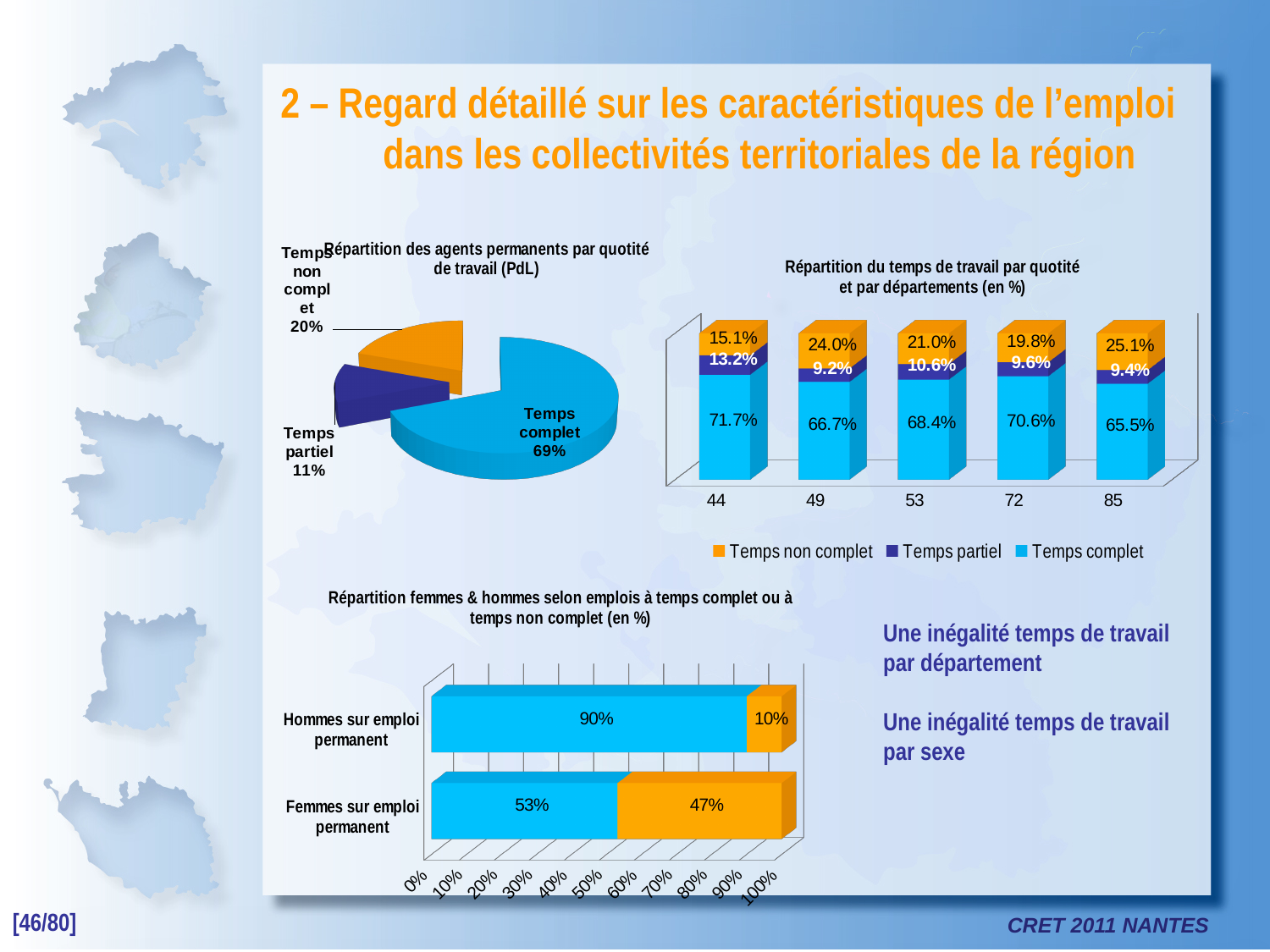
In the chart 'Répartition du temps de travail par quotité et par départements (en %)', what is the 'Temps complet' value for department 53? 68.4% In the pie chart 'Répartition des agents permanents par quotité de travail (PdL)', which category has the smallest slice? Temps partiel In the chart 'Répartition femmes & hommes selon emplois à temps complet ou à temps non complet (en %)', which category has the larger blue segment, 'Hommes sur emploi permanent' or 'Femmes sur emploi permanent'? Hommes sur emploi permanent In the chart 'Répartition du temps de travail par quotité et par départements (en %)', which department has the highest 'Temps partiel' value? 44 In the chart 'Répartition du temps de travail par quotité et par départements (en %)', how many series does the legend list? 3 In the chart 'Répartition du temps de travail par quotité et par départements (en %)', what kind of chart is it? Stacked bar chart In the pie chart 'Répartition des agents permanents par quotité de travail (PdL)', how many slices are there? 3 In the chart 'Répartition du temps de travail par quotité et par départements (en %)', what is the difference between the 'Temps non complet' values for departments 49 and 44? 8.9 percentage points In the chart 'Répartition du temps de travail par quotité et par départements (en %)', what is the 'Temps non complet' value for department 85? 25.1% In the chart 'Répartition femmes & hommes selon emplois à temps complet ou à temps non complet (en %)', what is the value of the orange segment for 'Femmes sur emploi permanent'? 47% In the chart 'Répartition du temps de travail par quotité et par départements (en %)', which department has the lowest 'Temps complet' value? 85 In the pie chart 'Répartition des agents permanents par quotité de travail (PdL)', what share is 'Temps complet'? 69%